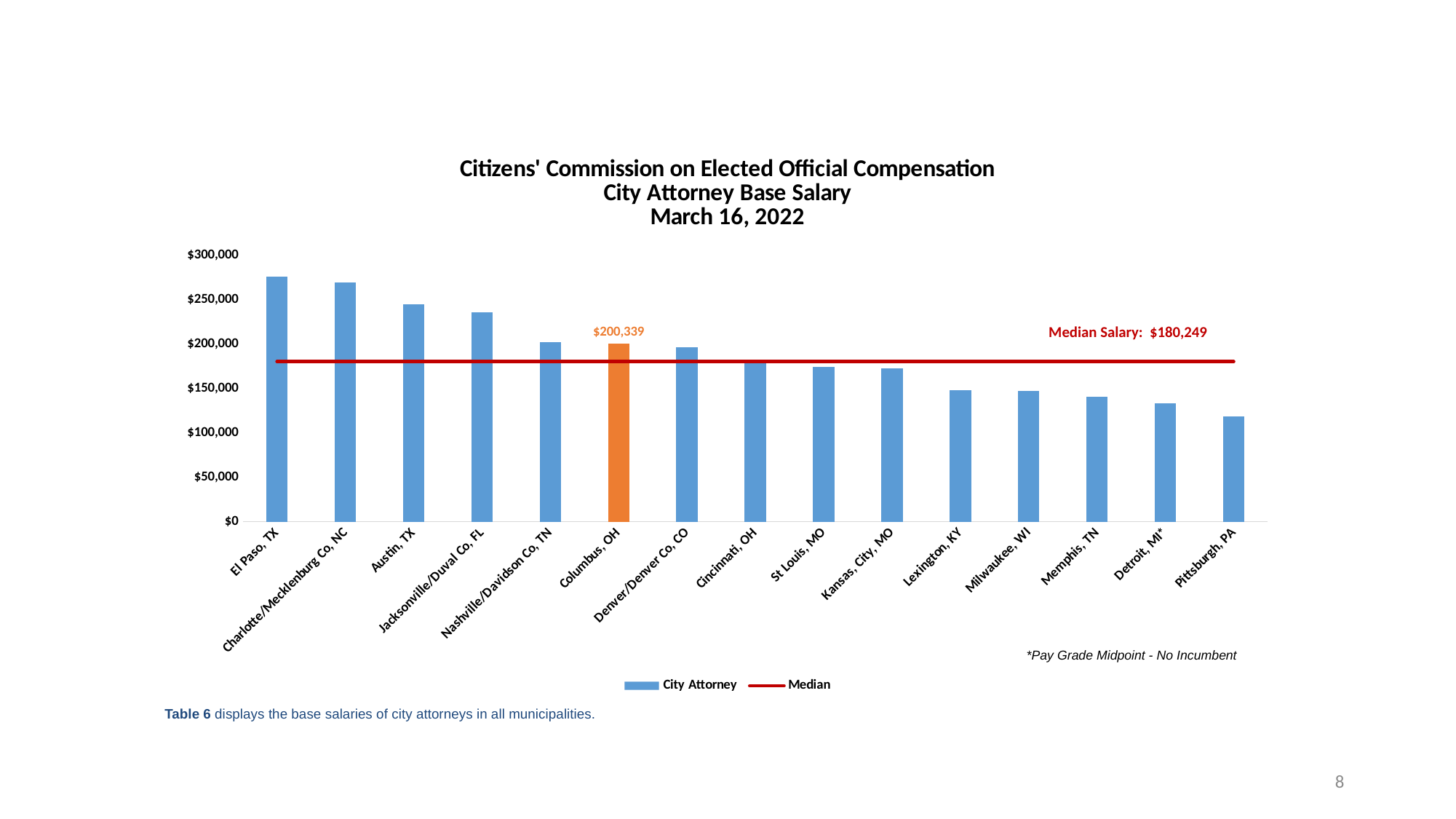
Is the value for Memphis, TN greater or less than $150,000? less What kind of chart is shown on the slide? Bar chart Which city has the lowest City Attorney base salary? Pittsburgh, PA Which has a higher City Attorney base salary, Austin, TX or Nashville/Davidson Co, TN? Austin, TX What is the City Attorney base salary shown for Columbus, OH? $200,339 What is the median salary shown on the chart? $180,249 Is the value for El Paso, TX greater or less than $250,000? greater Do the bar values rise or fall from left to right along the x axis? Fall How many series does the legend list? 2 How much higher is the Columbus, OH salary than the median salary? $20,090 Which city has the highest City Attorney base salary? El Paso, TX How many cities are shown on the x axis? 15